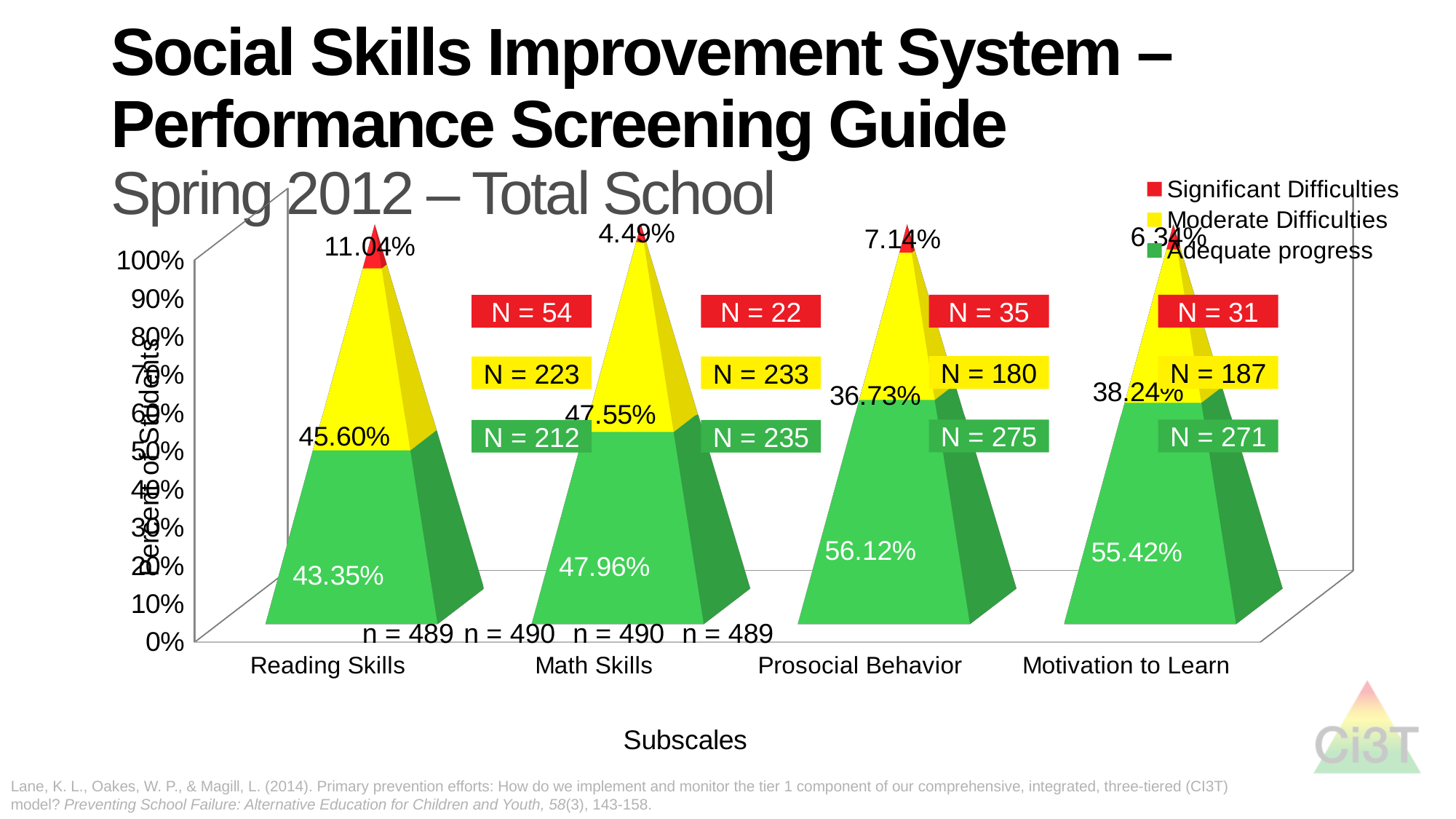
What kind of chart is shown on the slide? Stacked bar chart What percentage of students showed Adequate progress on the Prosocial Behavior subscale? 56.12% What is the total number of students (n) for the Reading Skills subscale? n = 489 How many subscales are shown on the x axis? 4 Which subscale has the highest percentage of students with Significant Difficulties? Reading Skills What is the difference between the Significant Difficulties percentages for Reading Skills and Math Skills? 6.55% How many students (N) showed Significant Difficulties on the Motivation to Learn subscale? N = 31 Which subscale has the lowest percentage of students with Adequate progress? Reading Skills What percentage of students showed Significant Difficulties on the Reading Skills subscale? 11.04% How many series does the legend list? 3 What percentage of students showed Moderate Difficulties on the Math Skills subscale? 47.55% Which is larger: the Adequate progress percentage for Prosocial Behavior or for Reading Skills? Prosocial Behavior